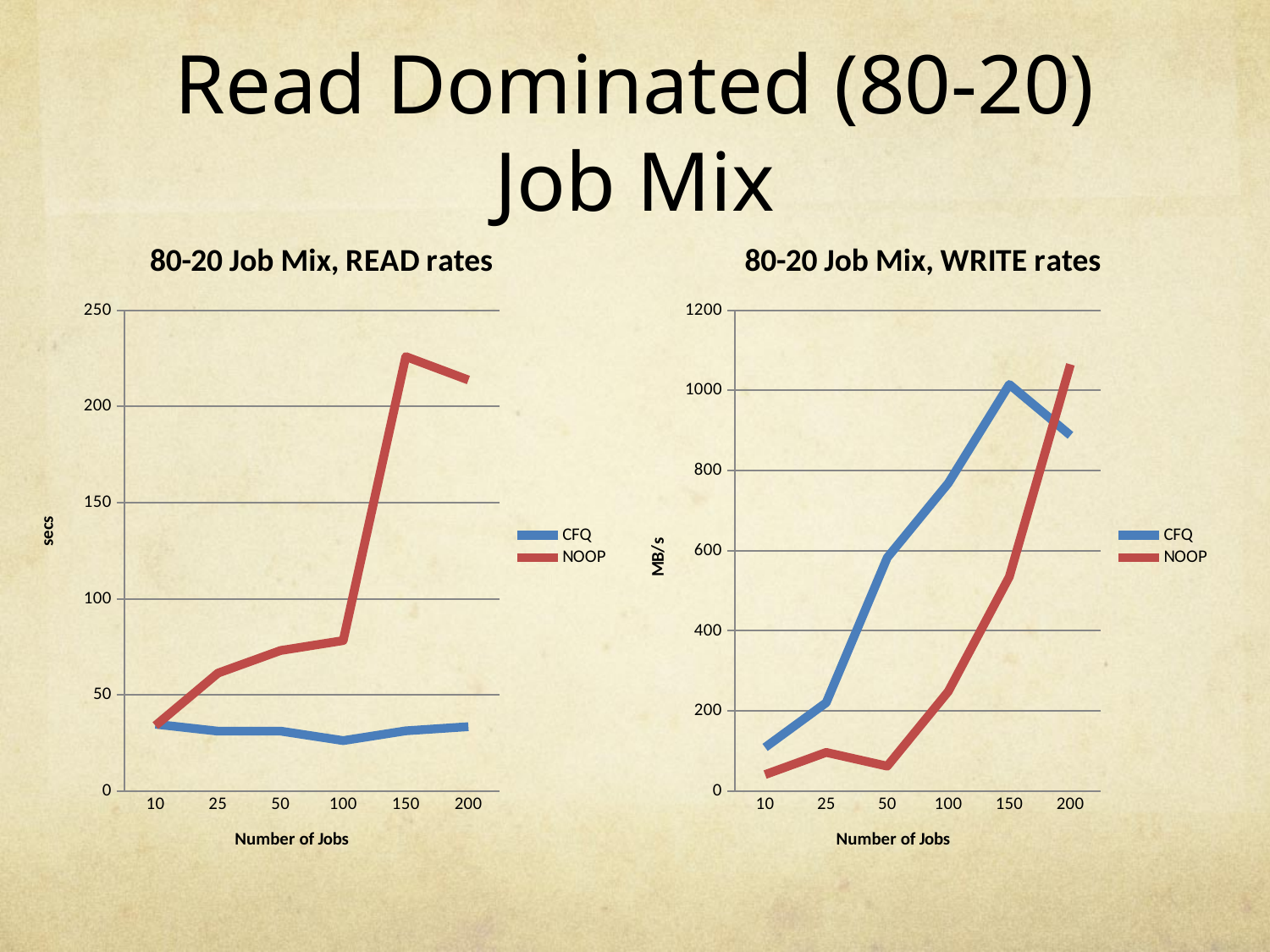
What kind of chart is the "80-20 Job Mix, READ rates" chart? line chart In the "80-20 Job Mix, WRITE rates" chart, which series has the higher value at 200 jobs, CFQ or NOOP? NOOP In the "80-20 Job Mix, READ rates" chart, at which number of jobs does the NOOP series reach its highest value? 150 In the "80-20 Job Mix, WRITE rates" chart, does the NOOP series generally rise or fall as the number of jobs increases from 50 to 200? rise In the "80-20 Job Mix, READ rates" chart, is the CFQ value at 100 jobs greater or less than 50? less How many series does the legend of the "80-20 Job Mix, WRITE rates" chart list? 2 In the "80-20 Job Mix, READ rates" chart, is the NOOP value at 150 jobs greater or less than 200? greater What is the y-axis label of the "80-20 Job Mix, WRITE rates" chart? MB/s In the "80-20 Job Mix, READ rates" chart, which series has the higher value at 150 jobs, CFQ or NOOP? NOOP In the "80-20 Job Mix, WRITE rates" chart, which series has the higher value at 100 jobs, CFQ or NOOP? CFQ How many Number of Jobs values are plotted along the x axis of the "80-20 Job Mix, READ rates" chart? 6